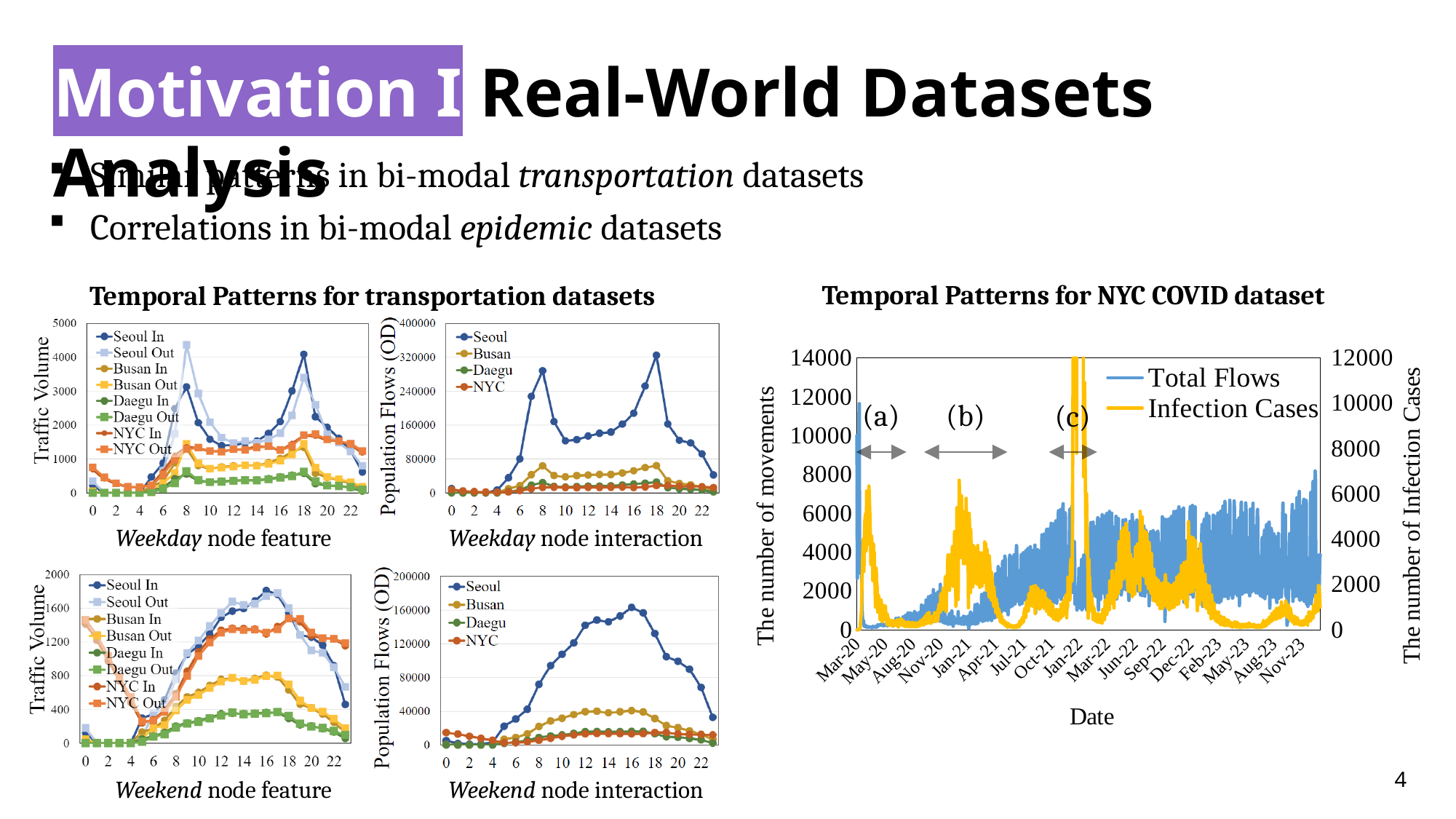
In the Temporal Patterns for NYC COVID dataset chart, what is the x-axis title? Date In the Temporal Patterns for NYC COVID dataset chart, how many series does the legend list? 2 In the Weekday node interaction chart, which city has the highest population flows at hour 18? Seoul In the Weekday node feature chart, is the value for Seoul In at hour 18 greater or less than 3000? greater In the Weekend node interaction chart, is the value for Seoul at hour 16 greater or less than 120000? greater In the Temporal Patterns for NYC COVID dataset chart, what is the label of the left y-axis? The number of movements In the Weekday node interaction chart, is the value for Seoul at hour 8 greater or less than 240000? greater In the Weekday node interaction chart, how many series does the legend list? 4 What kind of chart is the Temporal Patterns for NYC COVID dataset chart? Line chart In the Weekday node feature chart, how many series does the legend list? 8 In the Weekend node interaction chart, does the Seoul series rise or fall from hour 4 to hour 16? rise